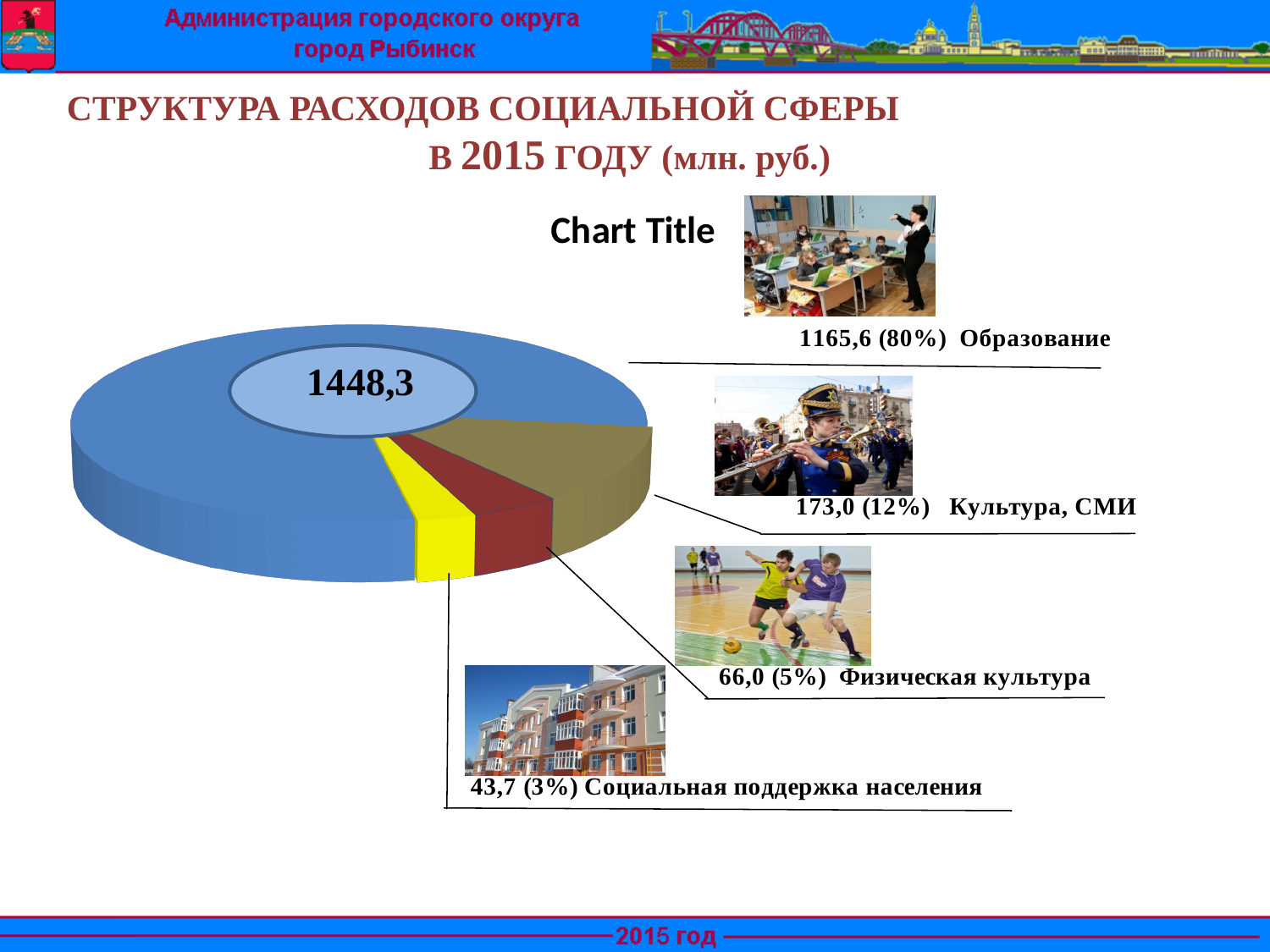
What total value is printed in the centre of the pie chart? 1448,3 What kind of chart is shown on the slide? pie chart Which is larger, the value for Физическая культура or the value for Социальная поддержка населения? Физическая культура What is the value for Физическая культура? 66,0 What is the value for Культура, СМИ? 173,0 What is the value for Социальная поддержка населения? 43,7 Which category has the smallest share of the pie? Социальная поддержка населения What is the value for Образование? 1165,6 What share of the pie does Физическая культура represent? 5% How many slices does the pie chart have? 4 What share of the pie does Культура, СМИ represent? 12% Which category has the largest share of the pie? Образование